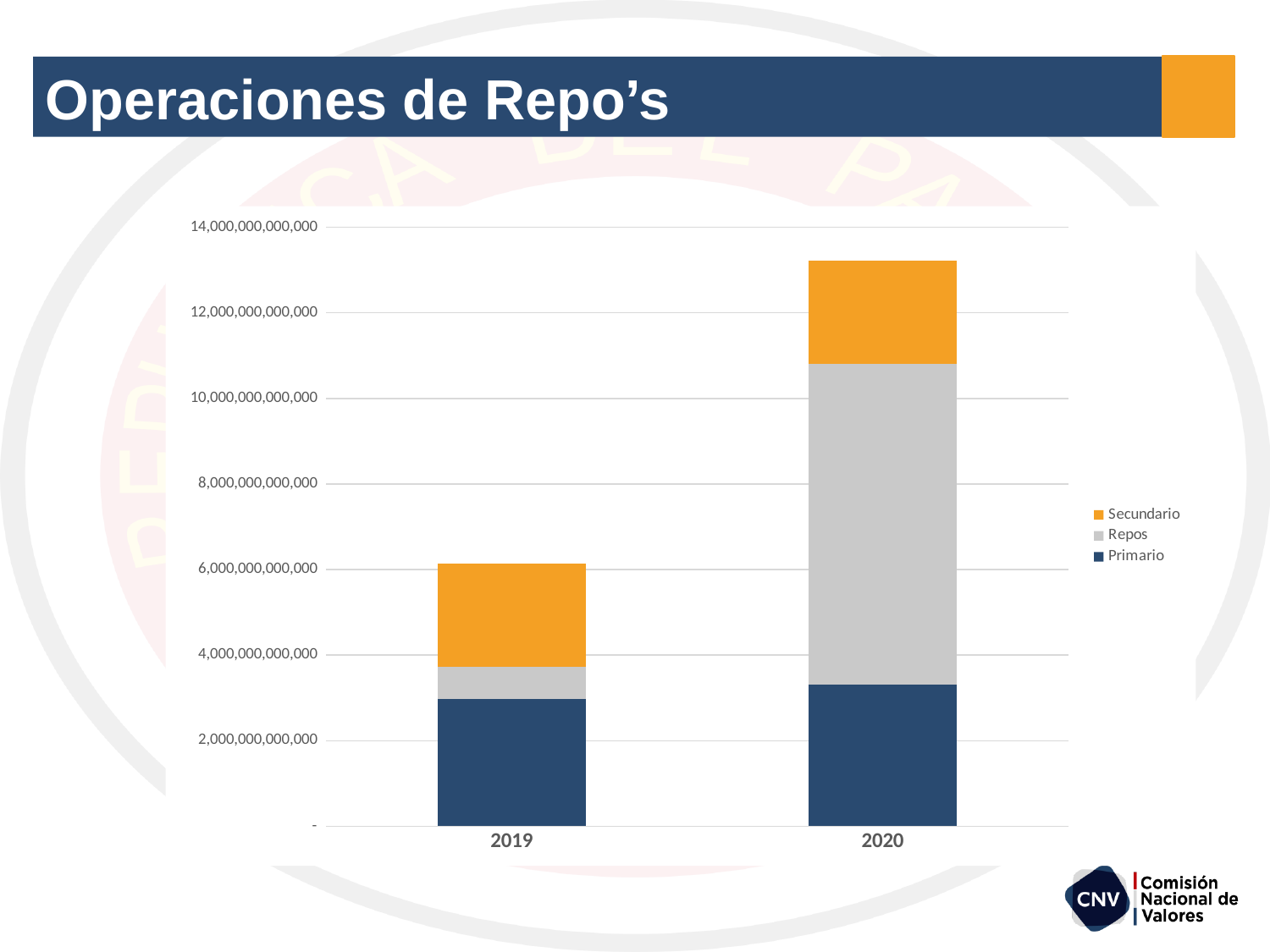
Which year has the taller stacked bar? 2020 What are the series names listed in the legend? Secundario, Repos, Primario Which year has the shorter stacked bar? 2019 How many years (categories) are shown on the x axis? 2 Is the Primario segment for 2019 greater or less than 4,000,000,000,000? less How many series does the legend list? 3 What is the title of the slide containing the chart? Operaciones de Repo's Does the total bar height rise or fall from 2019 to 2020? rise Is the Repos segment larger in 2019 or in 2020? 2020 What kind of chart is shown on the slide? Stacked bar chart Is the total of the 2019 bar greater or less than 8,000,000,000,000? less Is the total of the 2020 bar greater or less than 12,000,000,000,000? greater